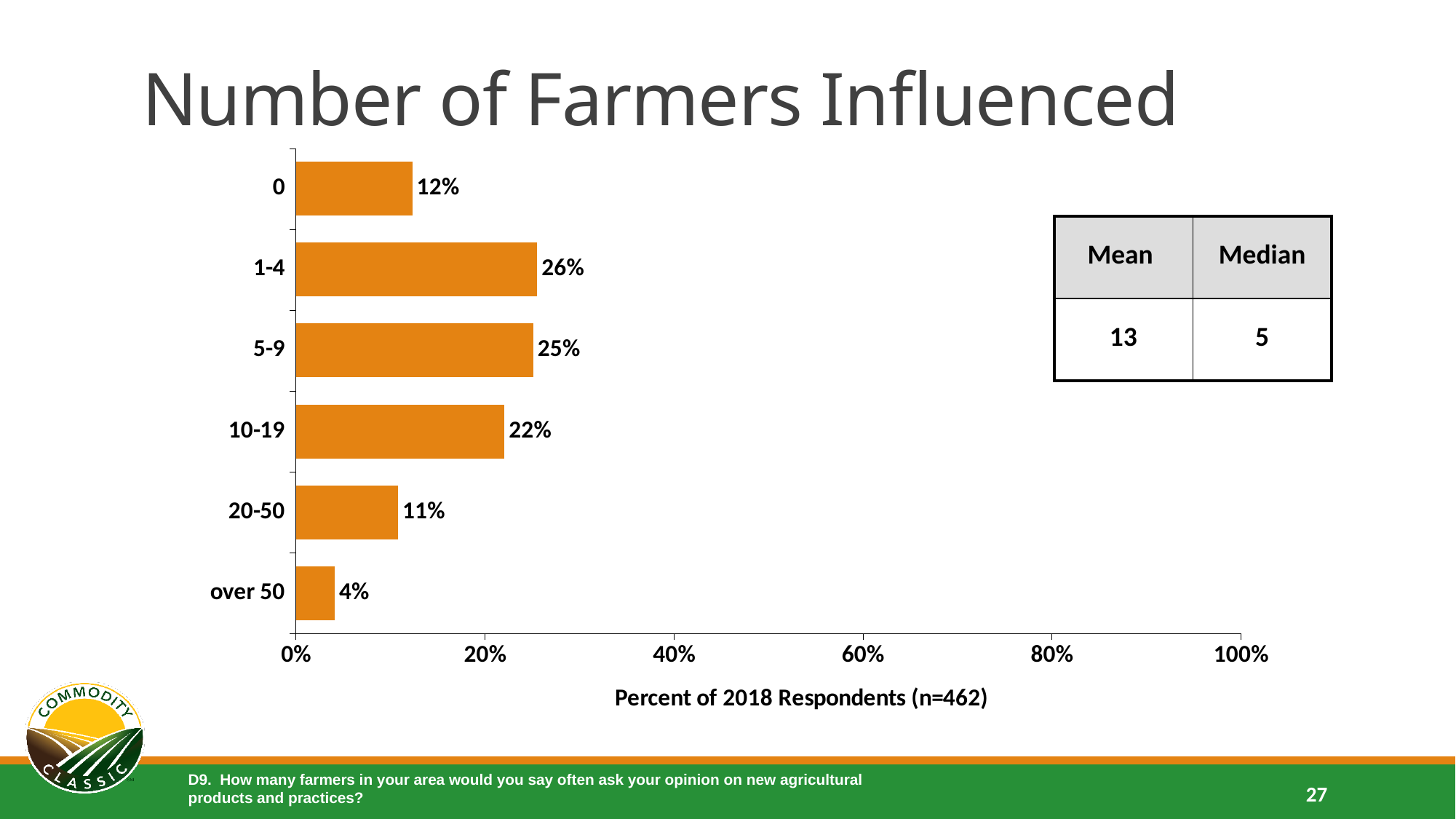
What is the x-axis label of the chart? Percent of 2018 Respondents (n=462) What kind of chart is shown on the slide? bar chart What percentage of respondents said they influenced 1-4 farmers? 26% What percentage of respondents said they influenced over 50 farmers? 4% Is the value for the 10-19 category greater or less than 20%? greater What percentage of respondents said they influenced 10-19 farmers? 22% Which category has the highest percentage of respondents? 1-4 Which category has the lowest percentage of respondents? over 50 Which category has a larger percentage, 0 or 20-50? 0 What is the difference in percentage points between the 5-9 category and the 20-50 category? 14 How many categories are shown on the chart? 6 What percentage of respondents said they influenced 0 farmers? 12%